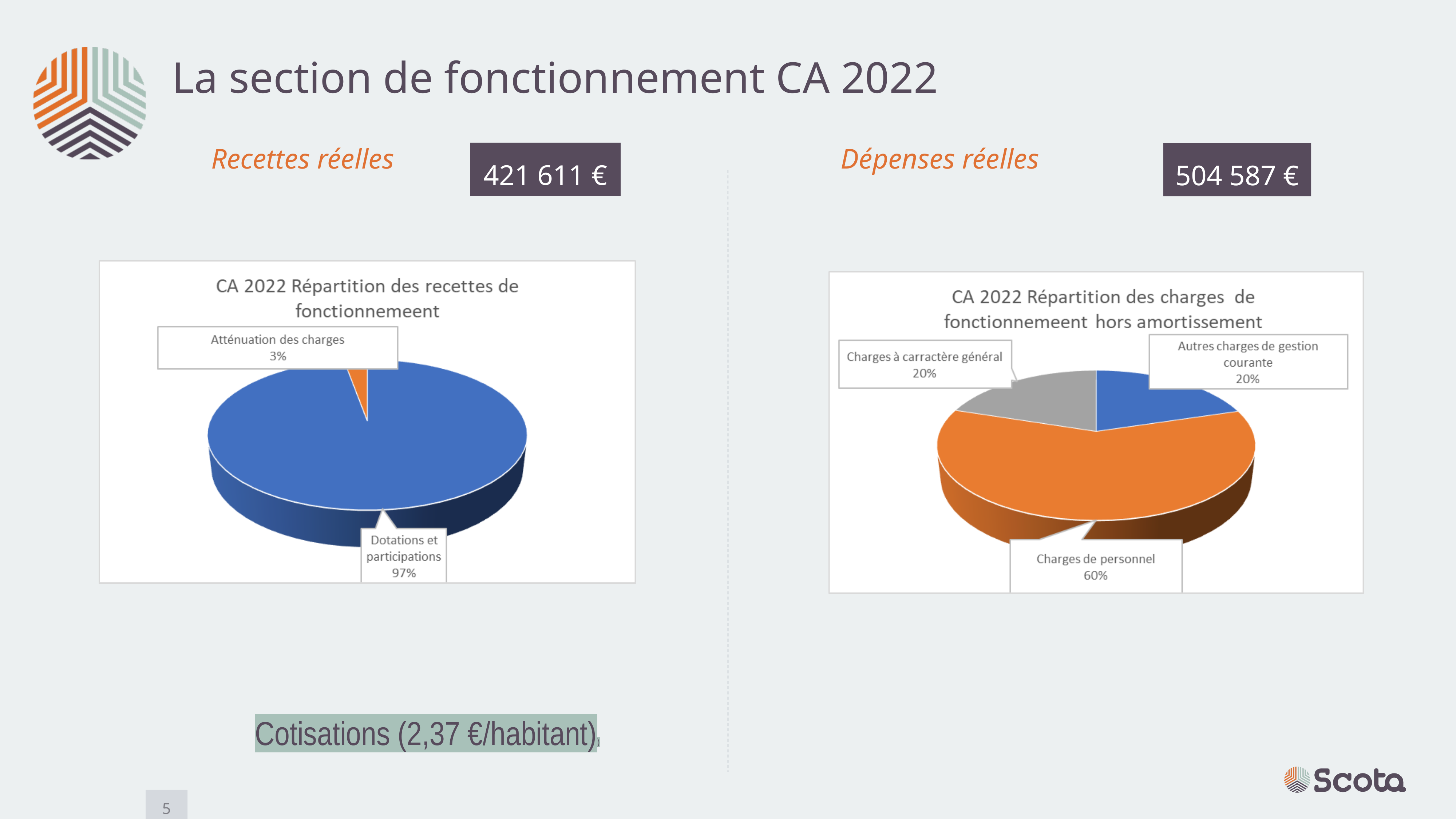
In the right chart (CA 2022 Répartition des charges de fonctionnemeent hors amortissement), what colour is the Charges de personnel slice? Orange In the right chart (CA 2022 Répartition des charges de fonctionnemeent hors amortissement), what is the difference in percentage points between Charges de personnel and Charges à carractère général? 40 percentage points In the left chart (CA 2022 Répartition des recettes de fonctionnemeent), what share does Atténuation des charges have? 3% In the right chart (CA 2022 Répartition des charges de fonctionnemeent hors amortissement), what share does Charges à carractère général have? 20% In the right chart (CA 2022 Répartition des charges de fonctionnemeent hors amortissement), how many slices does the pie have? 3 What kind of chart is the left chart (CA 2022 Répartition des recettes de fonctionnemeent)? Pie chart In the left chart (CA 2022 Répartition des recettes de fonctionnemeent), which category has the largest slice? Dotations et participations In the right chart (CA 2022 Répartition des charges de fonctionnemeent hors amortissement), which category has the largest slice? Charges de personnel In the right chart (CA 2022 Répartition des charges de fonctionnemeent hors amortissement), what share does Autres charges de gestion courante have? 20% In the left chart (CA 2022 Répartition des recettes de fonctionnemeent), how many slices does the pie have? 2